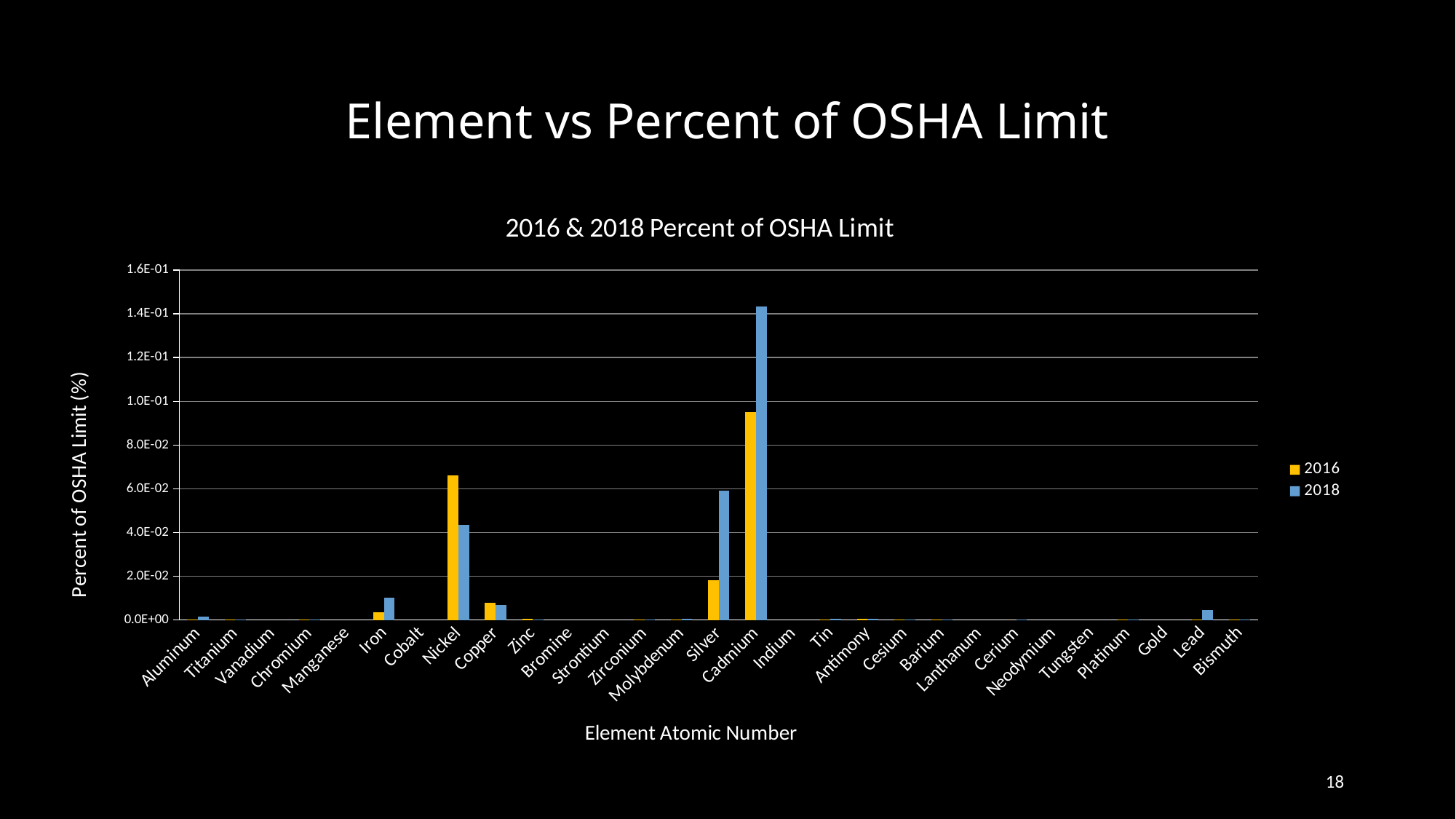
How many series does the legend list? 2 For Silver, which series has the larger value, 2016 or 2018? 2018 Is the 2018 value for Silver greater or less than 4.0E-02? greater How many element categories are shown on the x axis? 29 For Nickel, which series has the larger value, 2016 or 2018? 2016 What is the title of the y axis? Percent of OSHA Limit (%) Is the 2016 value for Cadmium greater or less than 1.0E-01? less Is the 2016 value for Nickel greater or less than 4.0E-02? greater What kind of chart is shown on the slide? bar chart Which element has the highest 2018 value? Cadmium Which element has the highest 2016 value? Cadmium